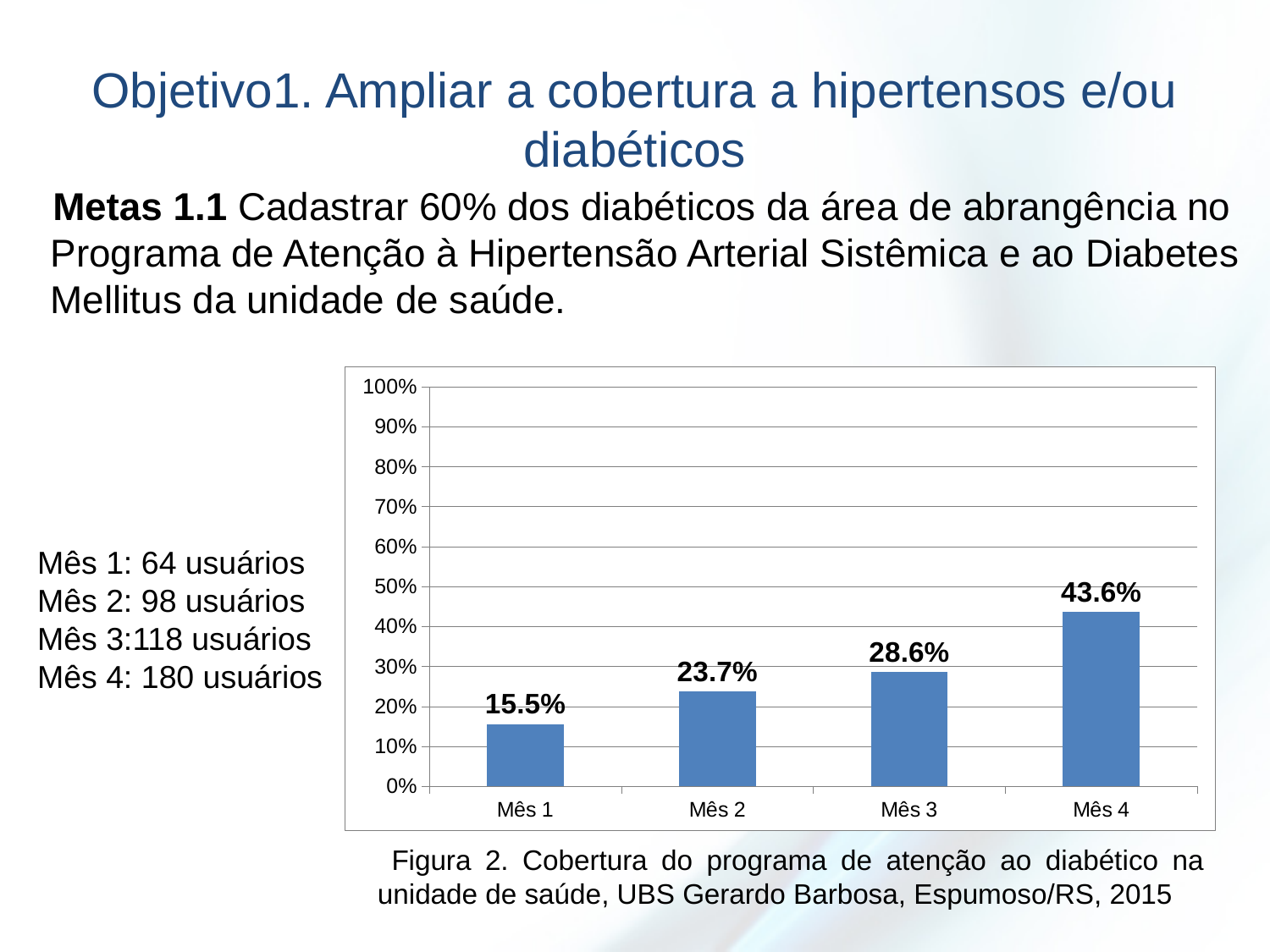
What kind of chart is shown on the slide? bar chart Do the values rise or fall from Mês 1 to Mês 4? rise Which month has the lowest value? Mês 1 What is the value for Mês 3? 28.6% What is the difference between the values for Mês 3 and Mês 2? 4.9% How many months are shown on the x axis? 4 Is the value for Mês 4 greater or less than 50%? less What is the value for Mês 4? 43.6% What is the difference between the values for Mês 4 and Mês 1? 28.1% Which is larger, the value for Mês 2 or the value for Mês 3? Mês 3 Which month has the highest value? Mês 4 What is the value for Mês 1? 15.5%